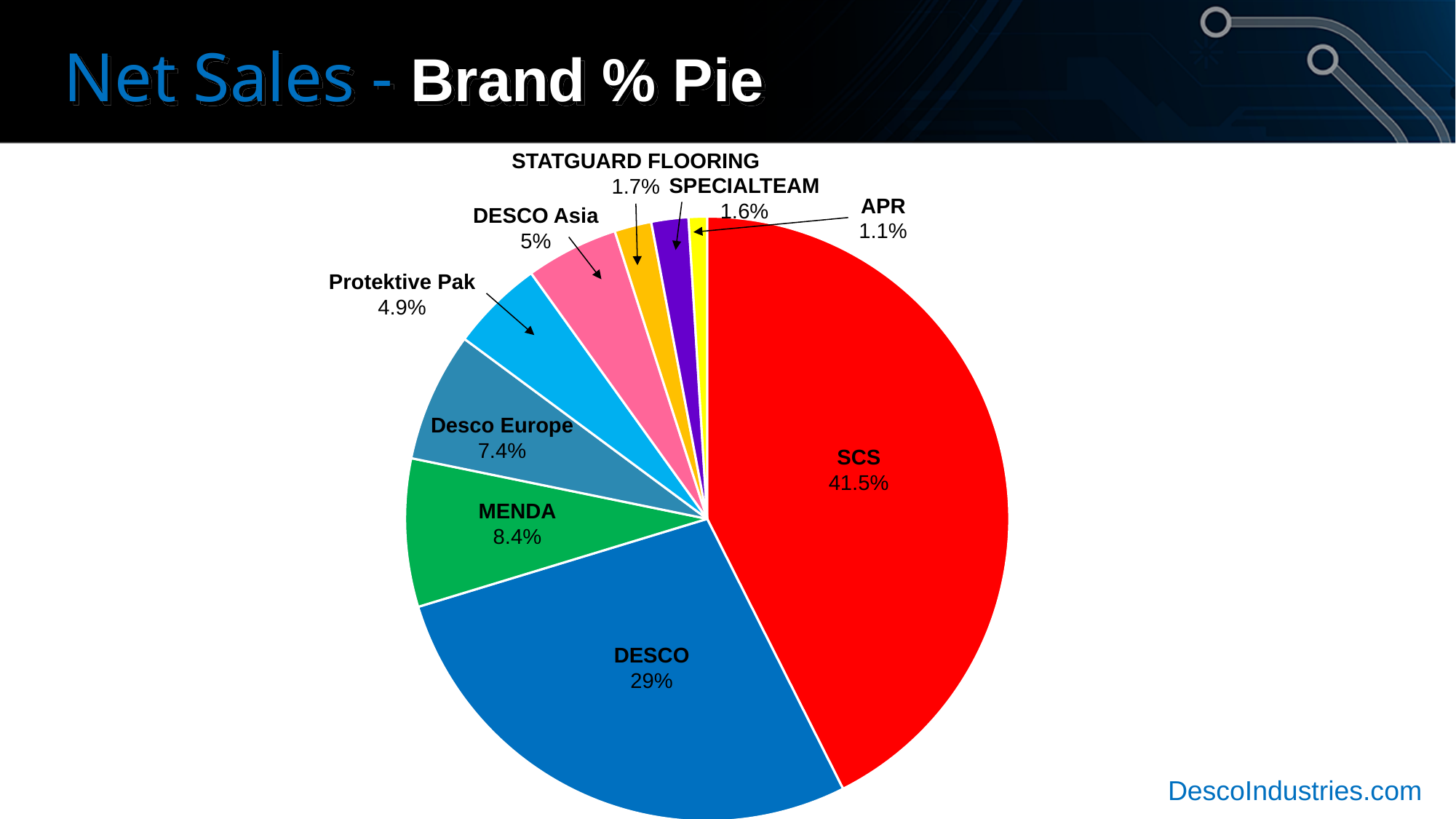
What kind of chart is shown on the slide? Pie chart What is the value for MENDA? 8.4% What percentage is shown for STATGUARD FLOORING? 1.7% Which brand has the largest share of the pie? SCS Which is larger, the share for DESCO Asia or the share for Protektive Pak? DESCO Asia What share of net sales does SCS account for? 41.5% What percentage is shown for DESCO? 29% What is the difference between the SCS and DESCO shares? 12.5% Which brand has the smallest share of the pie? APR How many brands are shown in the pie chart? 9 What percentage is shown for Desco Europe? 7.4% What is the value for Protektive Pak? 4.9%